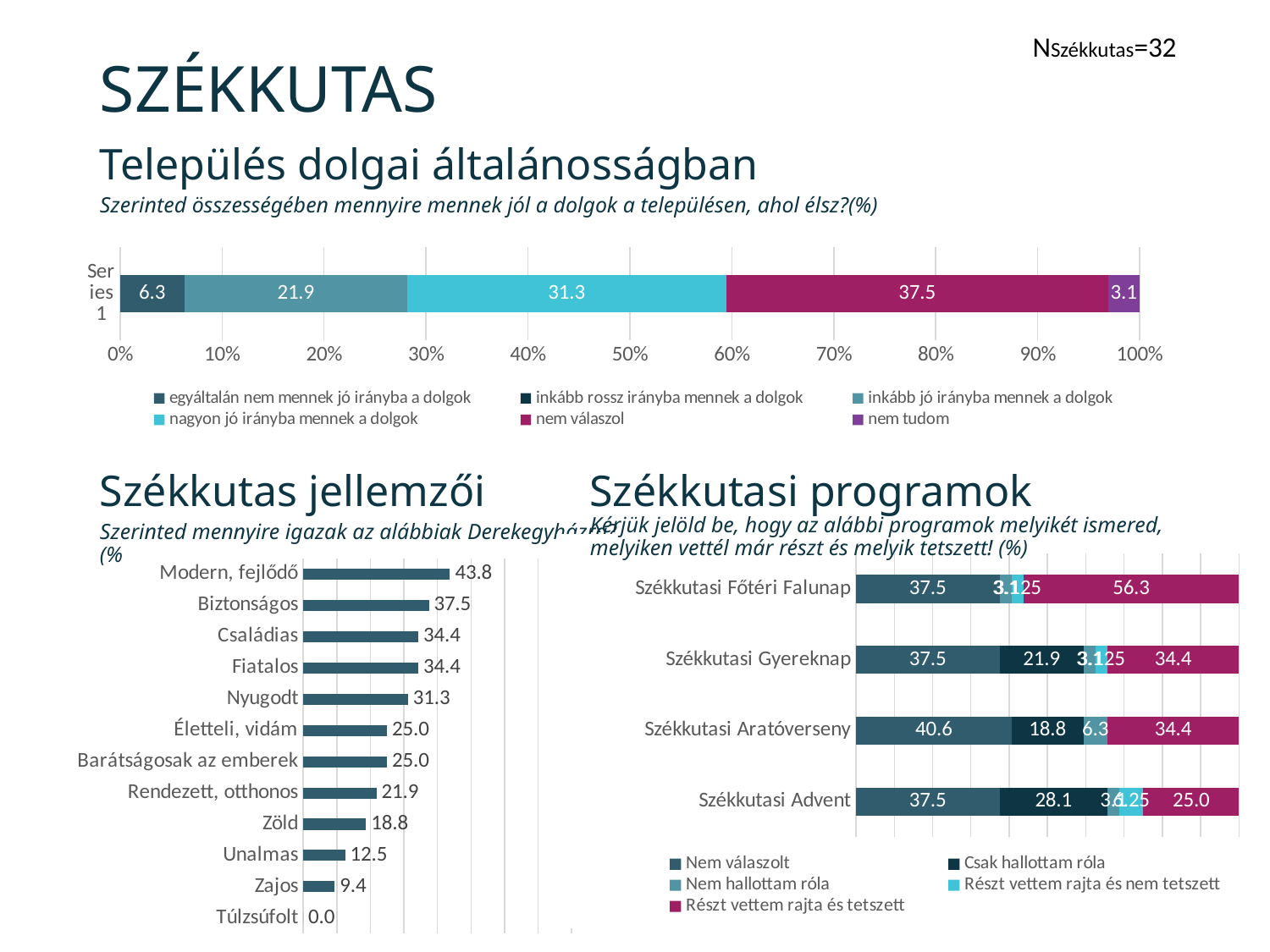
In the 'Település dolgai általánosságban' chart, how many entries does the legend list? 6 In the 'Székkutasi programok' chart, what is the 'Nem válaszolt' value for 'Székkutasi Aratóverseny'? 40.6 In the 'Székkutas jellemzői' chart, how many categories are shown? 12 In the 'Település dolgai általánosságban' chart, what is the value for 'nem tudom'? 3.1 In the 'Székkutas jellemzői' chart, which category has the highest value? Modern, fejlődő In the 'Székkutas jellemzői' chart, which category has the lowest value? Túlzsúfolt In the 'Székkutas jellemzői' chart, what is the value for 'Nyugodt'? 31.3 In the 'Székkutasi programok' chart, which program has the highest 'Részt vettem rajta és tetszett' value? Székkutasi Főtéri Falunap In the 'Székkutasi programok' chart, which is larger: the 'Csak hallottam róla' value for 'Székkutasi Advent' or for 'Székkutasi Gyereknap'? Székkutasi Advent In the 'Település dolgai általánosságban' chart, what is the value for 'nem válaszol'? 37.5 In the 'Székkutas jellemzői' chart, what is the difference between 'Biztonságos' and 'Zöld'? 18.7 What kind of chart is the 'Székkutas jellemzői' chart? Bar chart